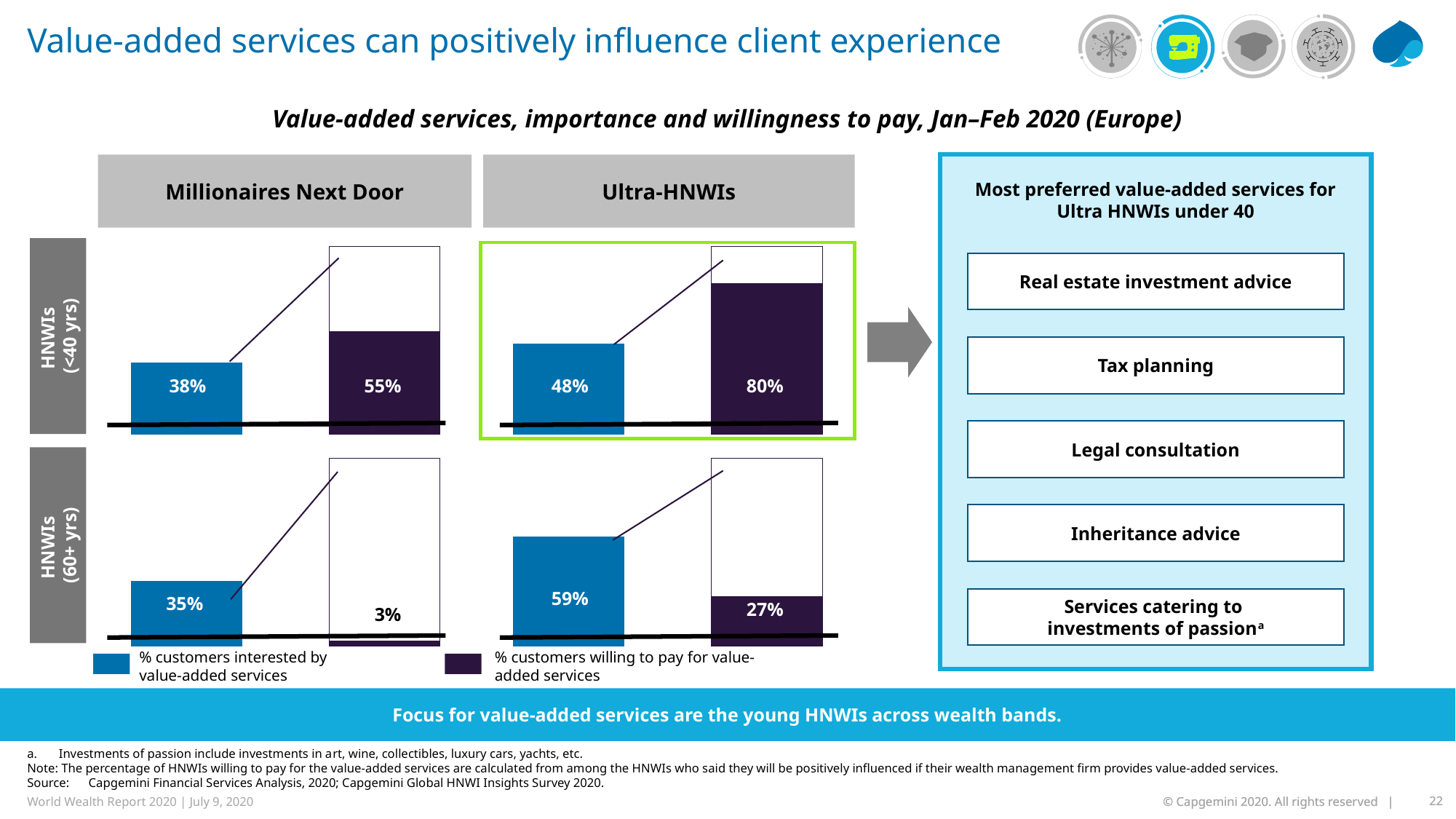
In the Millionaires Next Door chart for HNWIs aged 60+ years, what is the difference between the share interested and the share willing to pay for value-added services? 32 percentage points Across all four charts, which group has the lowest percentage of customers willing to pay for value-added services? Millionaires Next Door aged 60+ years (3%) In the Ultra-HNWIs chart for HNWIs under 40 years, what is the difference between the share willing to pay and the share interested in value-added services? 32 percentage points How many series does the legend list for the charts? 2 Across all four charts, which group has the highest percentage of customers willing to pay for value-added services? Ultra-HNWIs under 40 years (80%) In the Ultra-HNWIs chart for HNWIs under 40 years, what percentage of customers are willing to pay for value-added services? 80% In the Ultra-HNWIs chart for HNWIs aged 60+ years, what percentage of customers are interested by value-added services? 59% In the Millionaires Next Door chart for HNWIs under 40 years, what percentage of customers are interested by value-added services? 38% What type of chart is used to show the importance and willingness to pay for value-added services? bar chart For HNWIs under 40 years, is the share of Ultra-HNWIs interested in value-added services larger or smaller than the share of Millionaires Next Door interested? larger In the Ultra-HNWIs chart for HNWIs aged 60+ years, which is larger: the share interested in value-added services or the share willing to pay? the share interested (59%) In the Millionaires Next Door chart for HNWIs aged 60+ years, what percentage of customers are willing to pay for value-added services? 3%